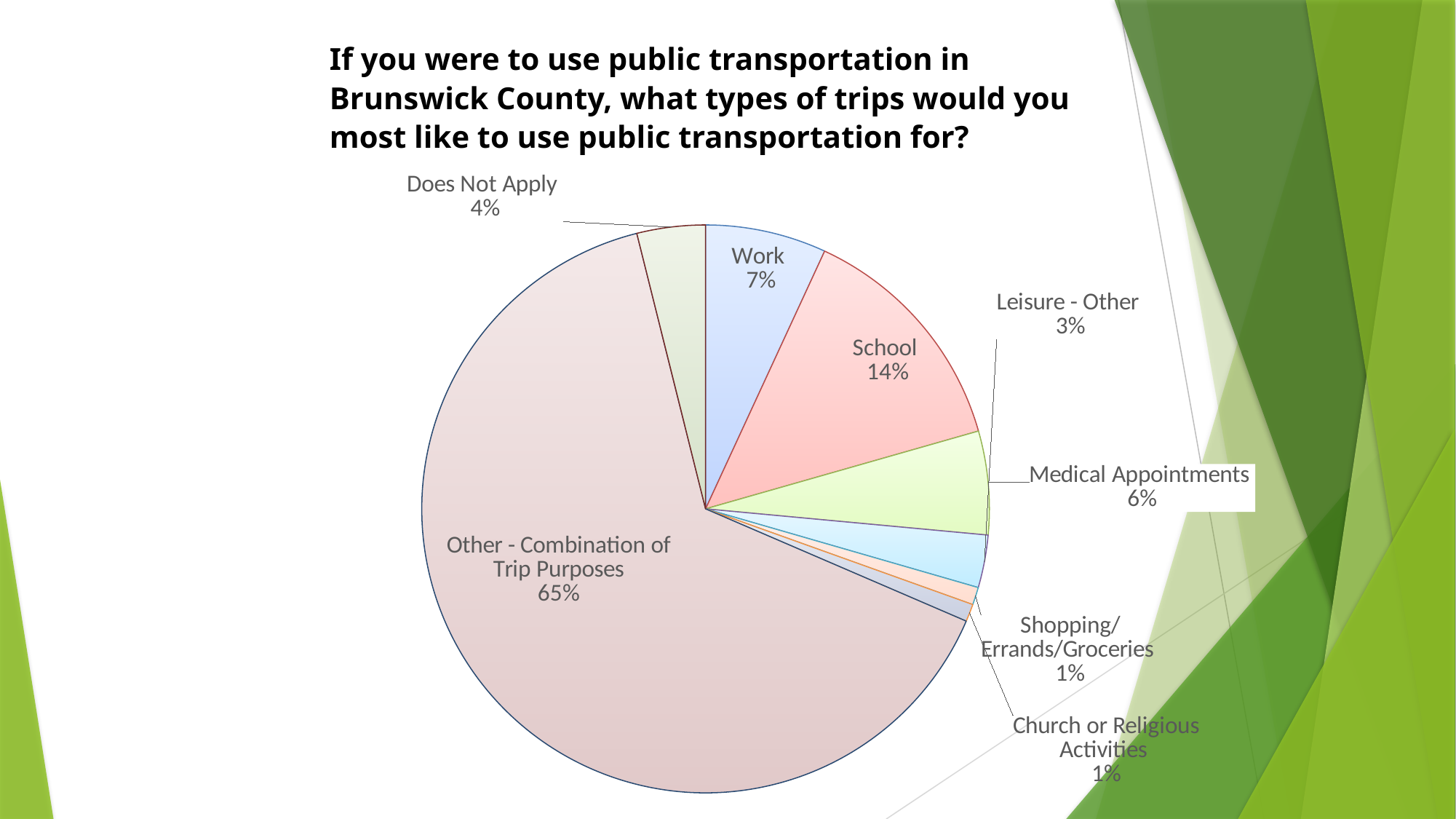
Which category has the largest share of the pie? Other - Combination of Trip Purposes What percentage is shown for Medical Appointments? 6% Which two categories each have a share of 1%? Shopping/Errands/Groceries and Church or Religious Activities How many categories are shown in the pie chart? 8 What share of the pie does Other - Combination of Trip Purposes take? 65% What percentage is shown for Does Not Apply? 4% What percentage of respondents chose School? 14% What percentage is shown for Work? 7% What type of chart is shown on the slide? pie chart What is the difference in percentage points between School and Work? 7 What percentage is shown for Leisure - Other? 3% Which is larger, the share for Medical Appointments or the share for Does Not Apply? Medical Appointments